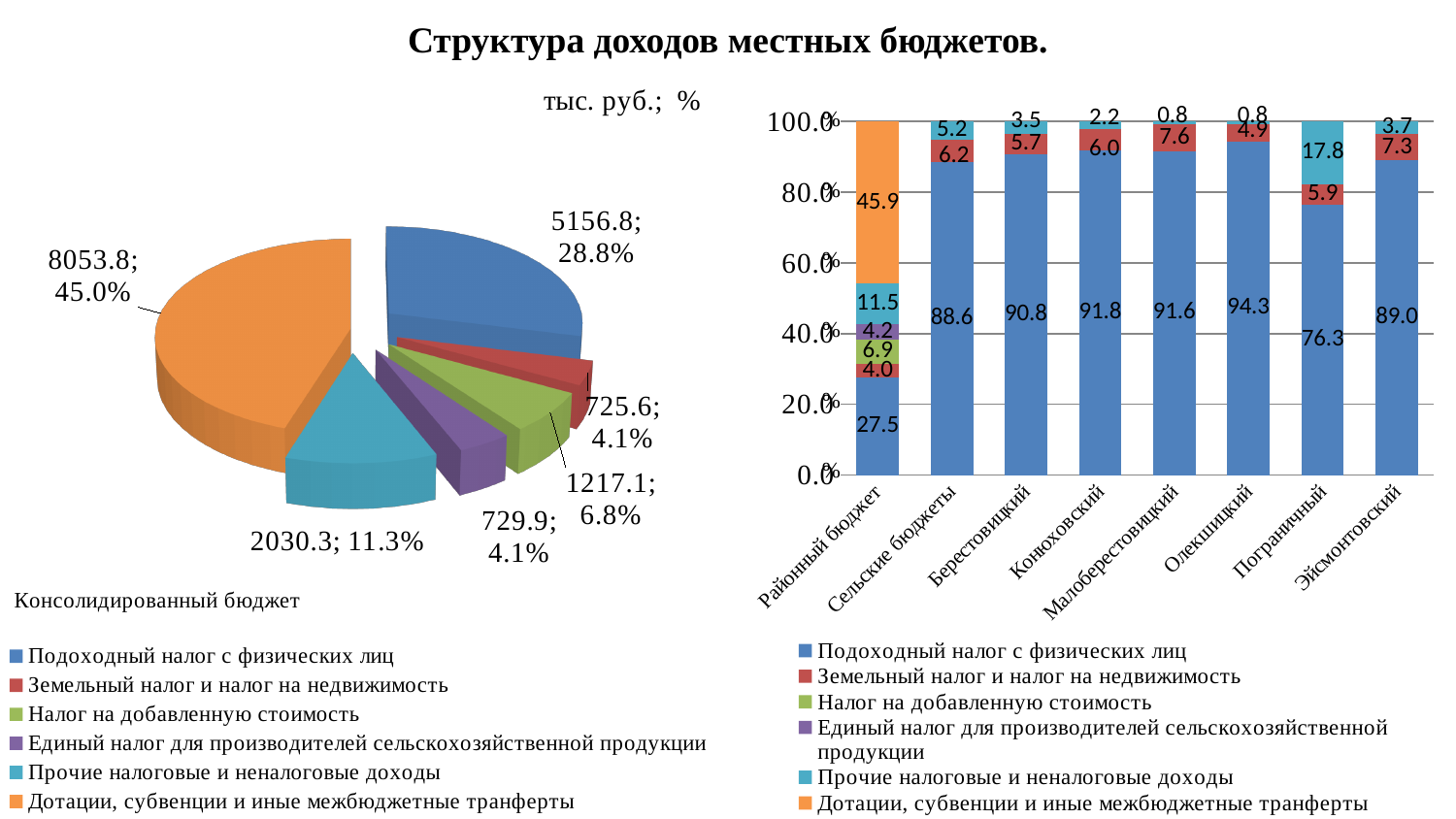
In the stacked bar chart on the right, what is the value of Подоходный налог с физических лиц for Олекшицкий? 94.3 In the pie chart on the left, what is the difference in thousand rubles between Прочие налоговые и неналоговые доходы (2030.3) and Налог на добавленную стоимость (1217.1)? 813.2 In the pie chart on the left, what is the value shown for Дотации, субвенции и иные межбюджетные трансферты? 8053.8; 45.0% In the stacked bar chart on the right, how many categories are shown on the x axis? 8 How many series does the legend of the stacked bar chart on the right list? 6 In the pie chart on the left, which category has the largest slice? Дотации, субвенции и иные межбюджетные трансферты In the pie chart on the left, what share does Подоходный налог с физических лиц have? 28.8% In the pie chart on the left, how many slices are there? 6 In the stacked bar chart on the right, what is the value of Дотации, субвенции и иные межбюджетные трансферты for Районный бюджет? 45.9 In the stacked bar chart on the right, which is larger: Прочие налоговые и неналоговые доходы for Пограничный or for Эйсмонтовский? Пограничный In the stacked bar chart on the right, which category has the lowest value of Подоходный налог с физических лиц? Районный бюджет What type of chart is shown on the right side of the slide? Stacked bar chart